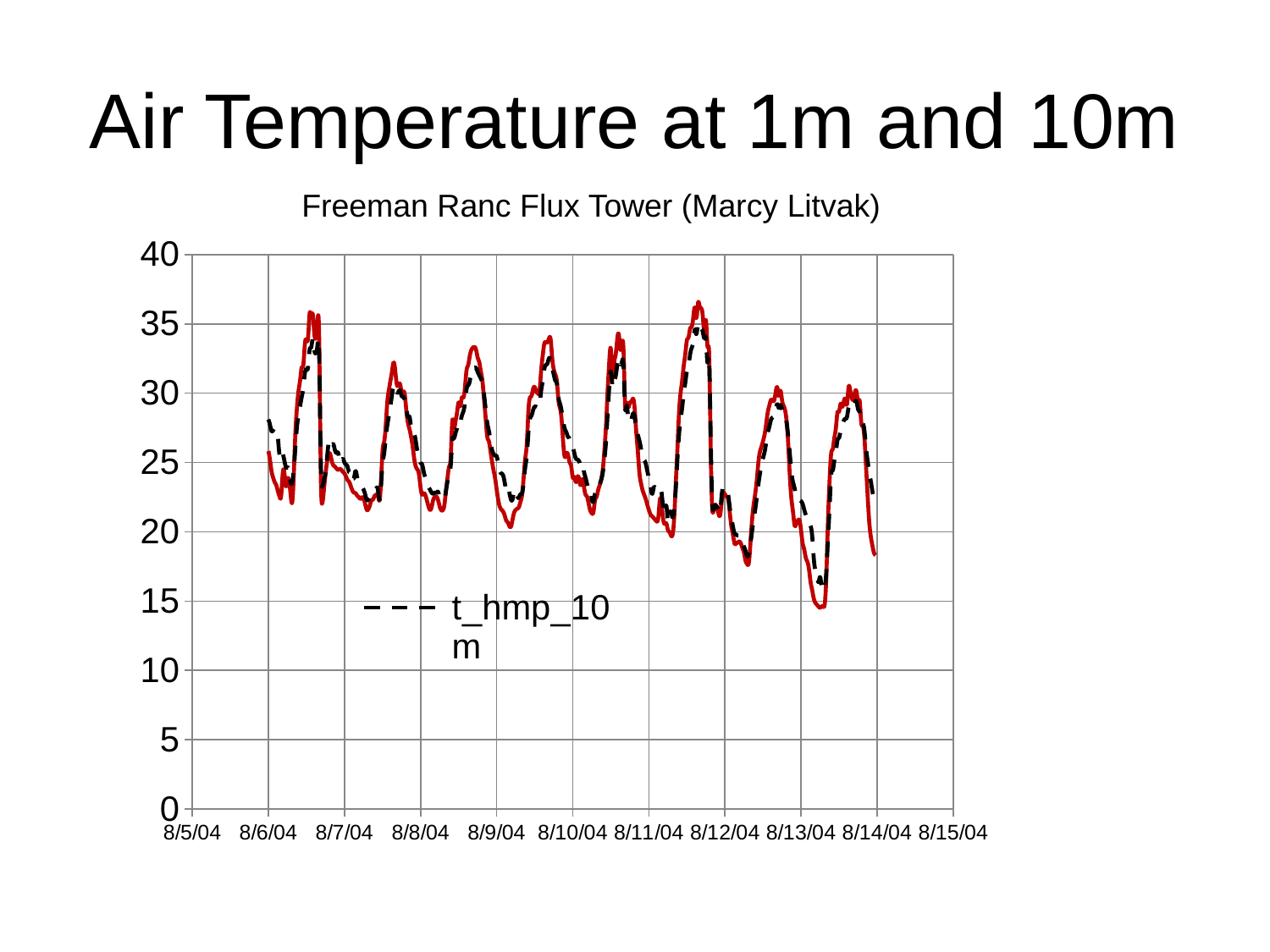
What kind of chart is shown on the slide? line chart Is the first value of the dashed t_hmp_10 m line at 8/6/04 greater or less than 25? greater Near the peak between 8/11/04 and 8/12/04, which line reaches the higher value, the red solid line or the black dashed line? the red solid line How many series does the chart's legend list? 1 Is the lowest value reached by the red solid line greater or less than 20? less How many date labels are shown along the x axis? 11 What is the title printed above the chart? Freeman Ranc Flux Tower (Marcy Litvak) Is the value of the dashed t_hmp_10 m line at the 8/12/04 gridline greater or less than 25? less What is the name of the series shown in the legend? t_hmp_10 m